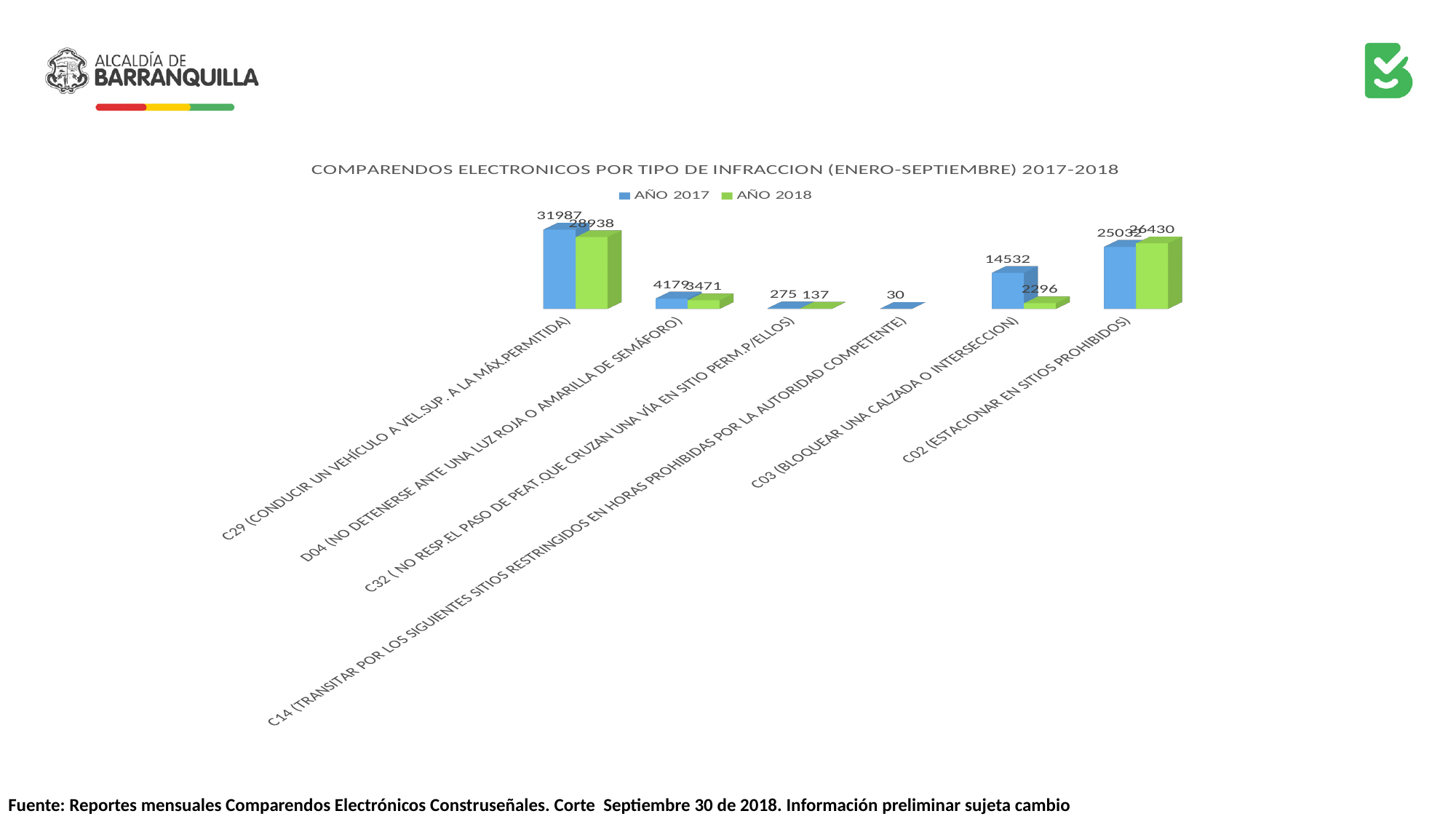
For C02 (ESTACIONAR EN SITIOS PROHIBIDOS), which year has the larger value, AÑO 2017 or AÑO 2018? AÑO 2018 How many infraction types are shown on the x axis? 6 What is the AÑO 2018 value for C02 (ESTACIONAR EN SITIOS PROHIBIDOS)? 26430 What is the AÑO 2018 value for C03 (BLOQUEAR UNA CALZADA O INTERSECCION)? 2296 Which infraction type has the lowest AÑO 2018 value among those with a 2018 bar? C32 ( NO RESP.EL PASO DE PEAT.QUE CRUZAN UNA VÍA EN SITIO PERM.P/ELLOS) What is the AÑO 2017 value for C14 (TRANSITAR POR LOS SIGUIENTES SITIOS RESTRINGIDOS EN HORAS PROHIBIDAS POR LA AUTORIDAD COMPETENTE)? 30 What is the difference between the AÑO 2017 and AÑO 2018 values for C03 (BLOQUEAR UNA CALZADA O INTERSECCION)? 12236 What kind of chart is shown on the slide? Bar chart How many series does the legend list? 2 What is the AÑO 2017 value for C29 (CONDUCIR UN VEHÍCULO A VEL.SUP. A LA MÁX.PERMITIDA)? 31987 Which infraction type has the highest AÑO 2017 value? C29 (CONDUCIR UN VEHÍCULO A VEL.SUP. A LA MÁX.PERMITIDA) What is the difference between the AÑO 2017 and AÑO 2018 values for D04 (NO DETENERSE ANTE UNA LUZ ROJA O AMARILLA DE SEMÁFORO)? 708